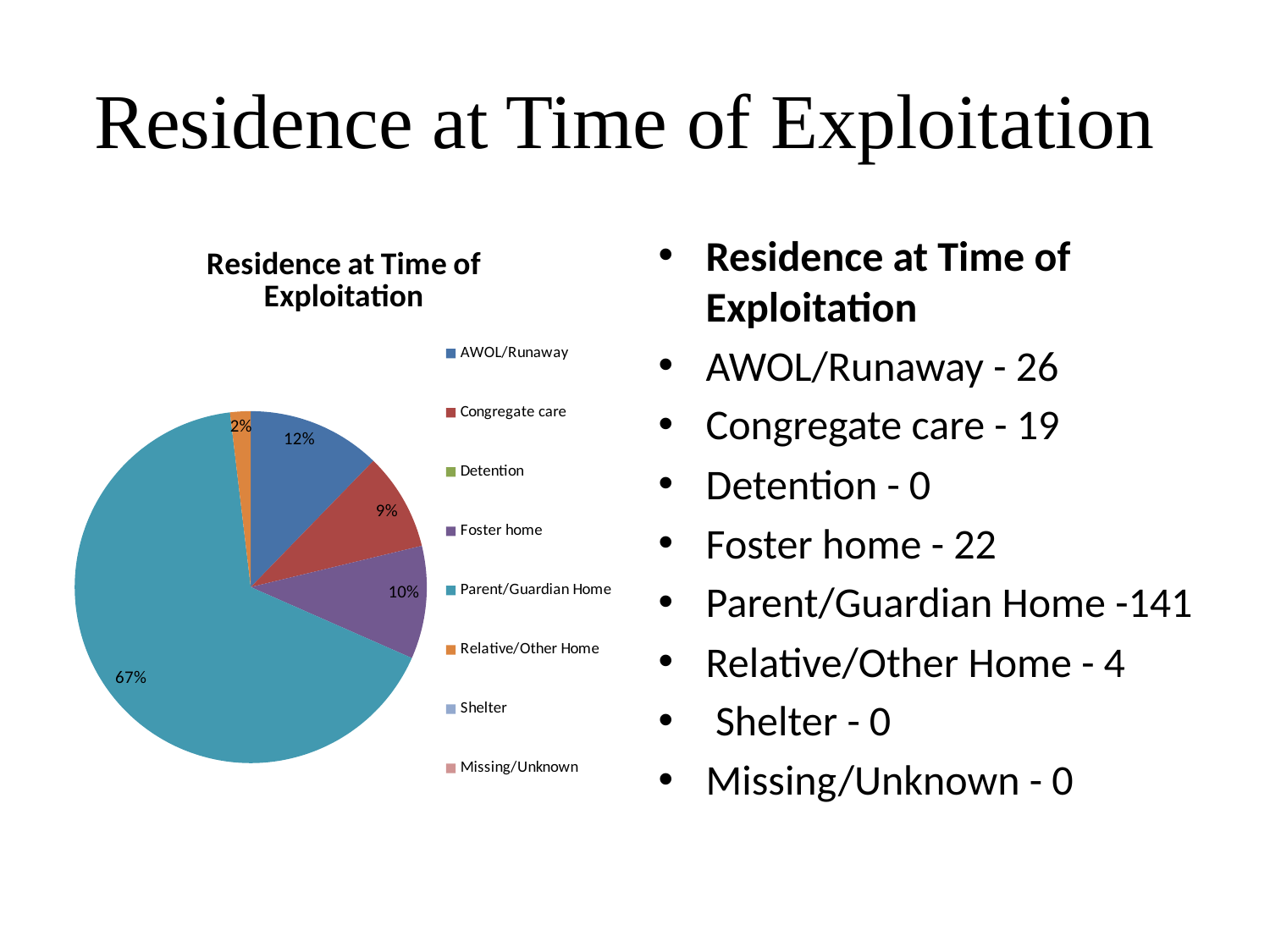
What is the difference in percentage points between the Parent/Guardian Home slice and the AWOL/Runaway slice? 55% What share of the pie does Congregate care represent? 9% What is the title of the chart? Residence at Time of Exploitation What share of the pie does Foster home represent? 10% What kind of chart is shown on the slide? pie chart What share of the pie does Parent/Guardian Home represent? 67% Which category has the largest slice of the pie? Parent/Guardian Home Which slice is larger, AWOL/Runaway or Congregate care? AWOL/Runaway Which of the labelled slices is the smallest? Relative/Other Home How many entries does the chart's legend list? 8